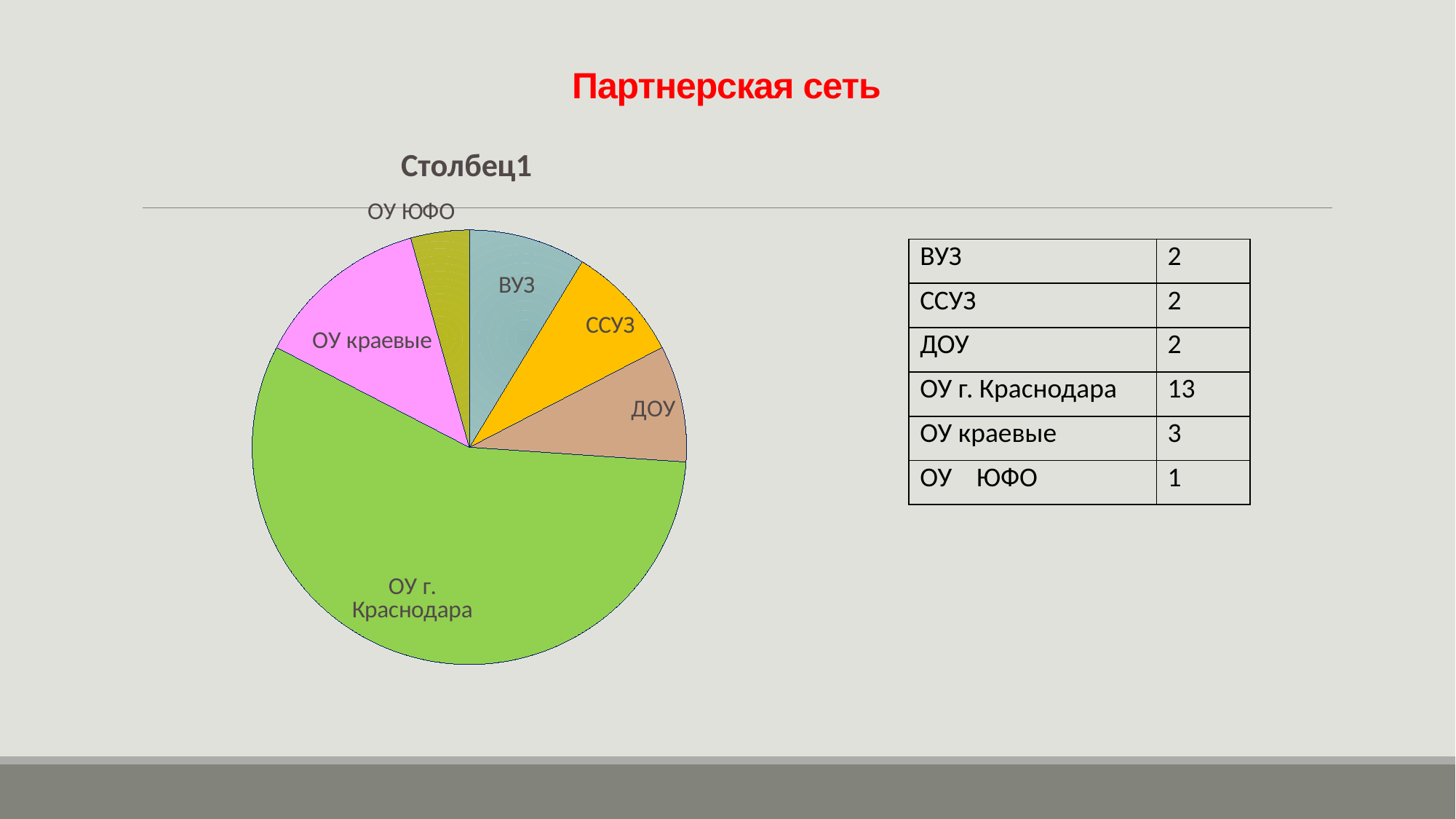
Which is larger, the slice for ОУ краевые or the slice for ОУ ЮФО? ОУ краевые What is the title of the chart? Столбец1 What kind of chart is shown on the slide? pie chart What is the value for ОУ краевые? 3 What is the value for ОУ ЮФО? 1 What is the value for ОУ г. Краснодара? 13 What is the difference between the values for ОУ г. Краснодара and ОУ краевые? 10 What is the value for ВУЗ? 2 Which category has the largest slice of the pie? ОУ г. Краснодара What is the total of all the values shown in the table for the pie chart? 23 How many slices does the pie chart have? 6 Which category has the smallest slice of the pie? ОУ ЮФО